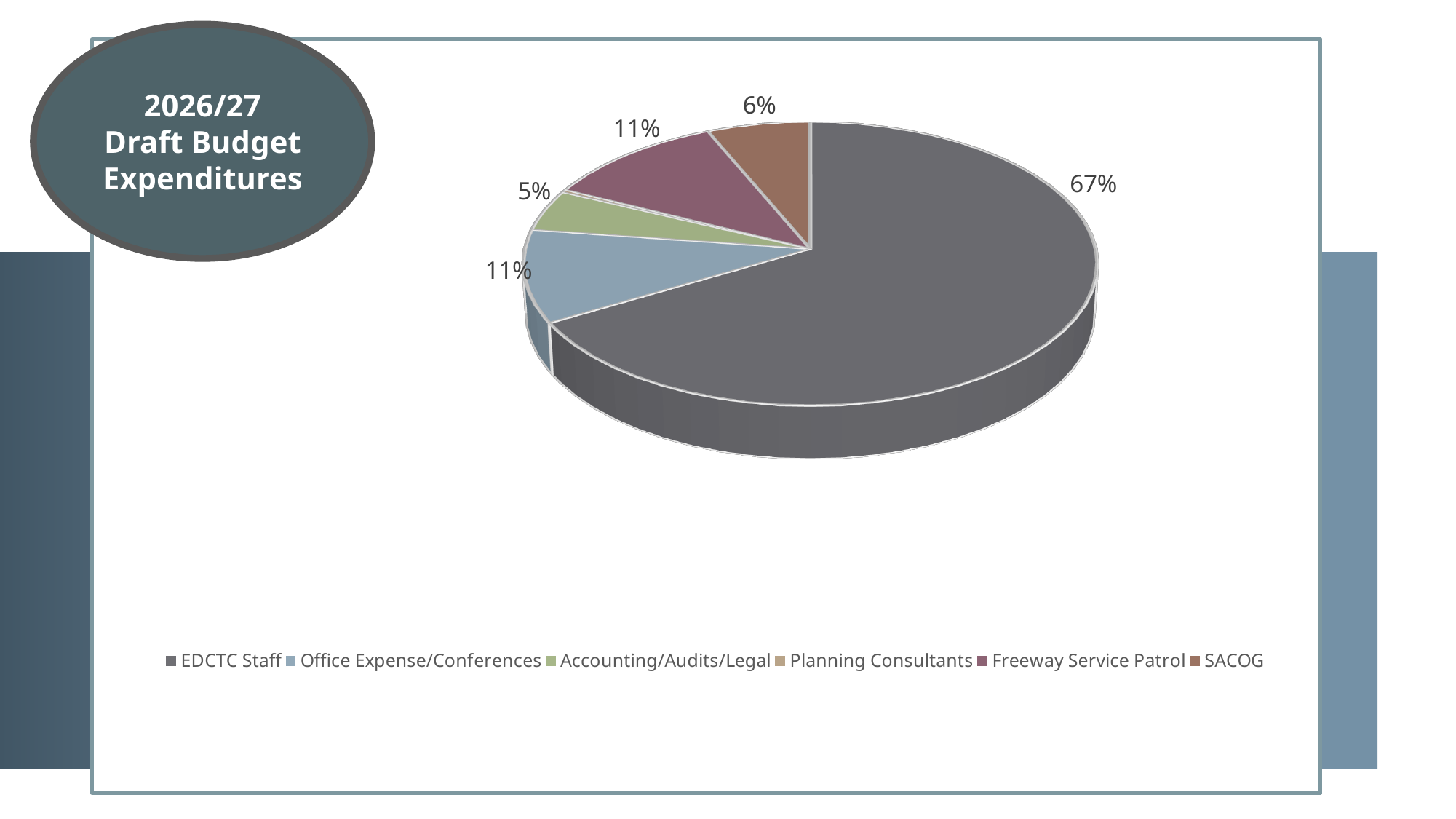
Which is larger, the slice for Office Expense/Conferences or the slice for Accounting/Audits/Legal? Office Expense/Conferences What share of expenditures is labeled for Freeway Service Patrol? 11% What is the title shown in the oval on the slide? 2026/27 Draft Budget Expenditures What kind of chart is shown on the slide? Pie chart What share of the 2026/27 Draft Budget Expenditures goes to EDCTC Staff? 67% How many percentage points larger is the EDCTC Staff share than the SACOG share? 61 percentage points What share of expenditures is labeled for Accounting/Audits/Legal? 5% How many categories does the legend list? 6 Which is larger, the slice for SACOG or the slice for Freeway Service Patrol? Freeway Service Patrol Which category has the largest slice of the pie? EDCTC Staff